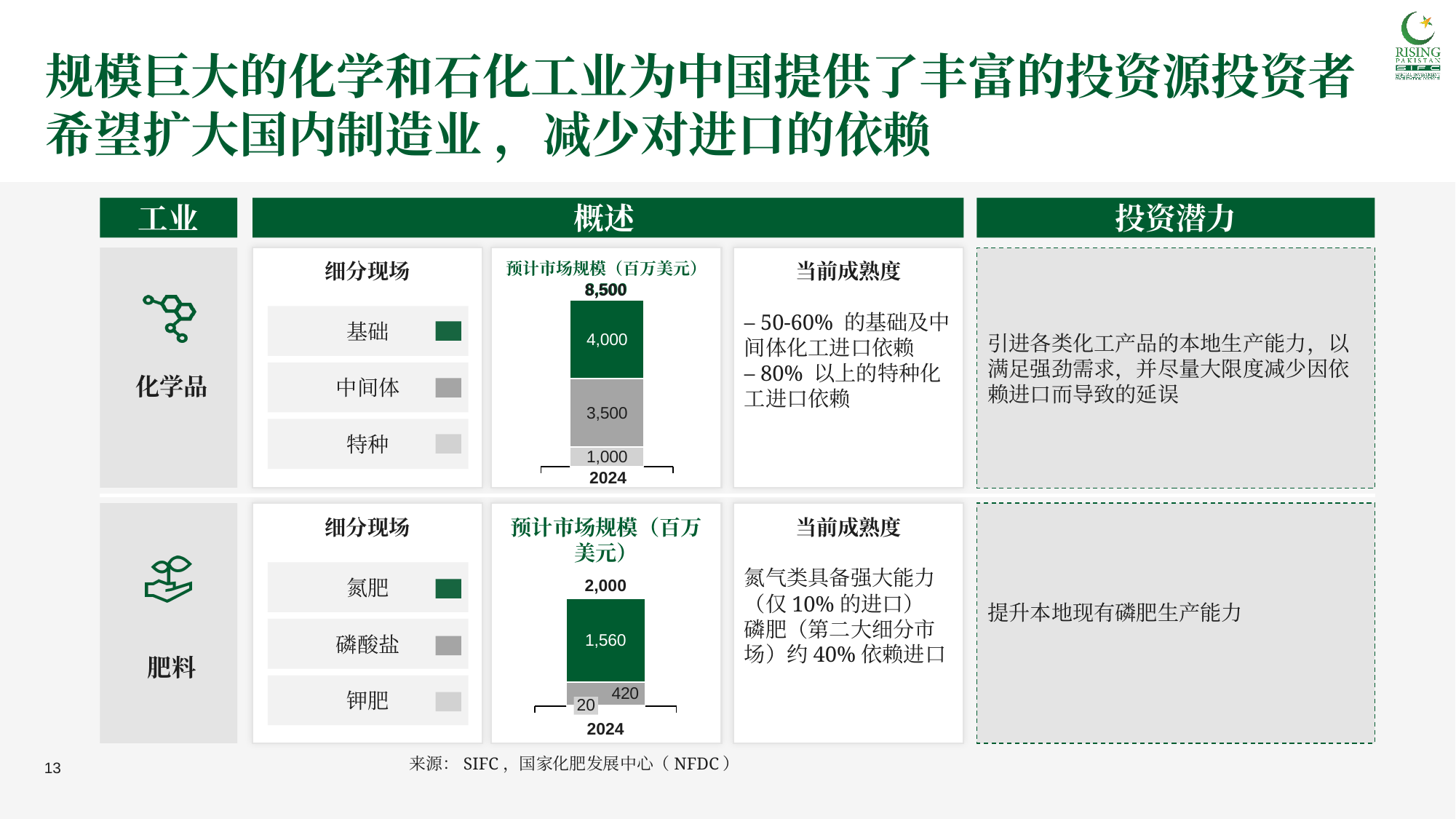
How many segments does the fertilizer (肥料) market size bar for 2024 contain? 3 In the fertilizer (肥料) market size chart, what is the total of the stacked bar for 2024? 2,000 In the chemicals (化学品) market size chart, what is the total of the stacked bar for 2024? 8,500 What type of chart is used to show the projected market size for chemicals (化学品)? Stacked bar chart In the chemicals (化学品) market size chart, what is the value of the 基础 segment for 2024? 4,000 In the fertilizer (肥料) market size chart, which is larger, the 磷酸盐 segment or the 钾肥 segment? 磷酸盐 In the chemicals (化学品) market size chart, which segment is the smallest? 特种 In the fertilizer (肥料) market size chart, which segment is the largest? 氮肥 In the chemicals (化学品) market size chart, what is the value of the 中间体 segment? 3,500 In the fertilizer (肥料) market size chart, what is the value of the 钾肥 segment? 20 In the chemicals (化学品) market size chart, what is the difference between the 基础 and 中间体 segments? 500 In the fertilizer (肥料) market size chart, what is the value of the 氮肥 segment? 1,560